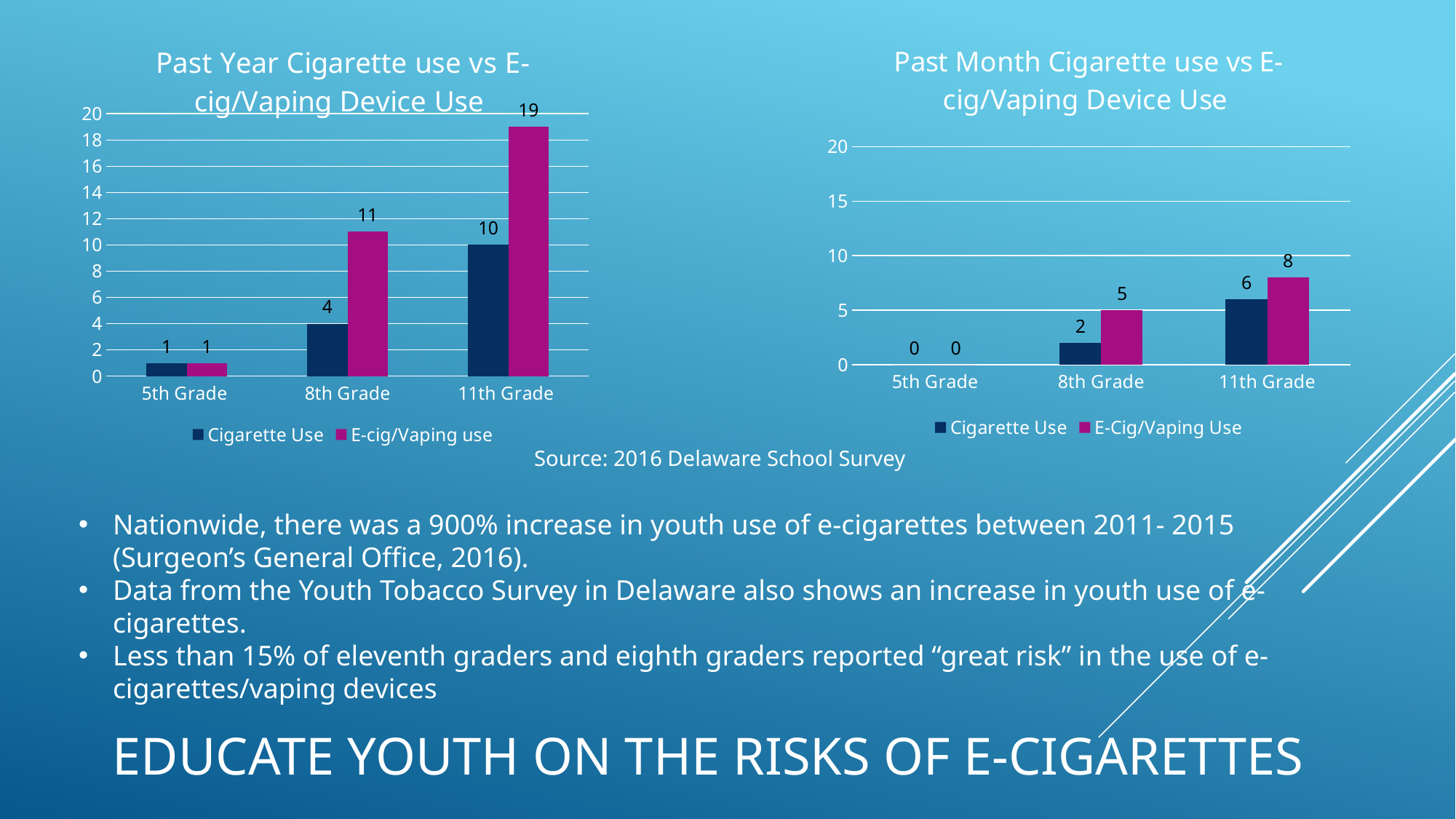
In the 'Past Year Cigarette use vs E-cig/Vaping Device Use' chart, which grade has the highest E-cig/Vaping use? 11th Grade In the 'Past Year Cigarette use vs E-cig/Vaping Device Use' chart, what is the E-cig/Vaping use value for 11th Grade? 19 In the 'Past Year Cigarette use vs E-cig/Vaping Device Use' chart, how many grade categories are shown? 3 What kind of chart is the 'Past Year Cigarette use vs E-cig/Vaping Device Use' chart? Bar chart In the 'Past Month Cigarette use vs E-cig/Vaping Device Use' chart, which is larger for 11th Grade: Cigarette Use or E-Cig/Vaping Use? E-Cig/Vaping Use In the 'Past Year Cigarette use vs E-cig/Vaping Device Use' chart, do E-cig/Vaping use values rise or fall from 5th Grade to 11th Grade? Rise In the 'Past Month Cigarette use vs E-cig/Vaping Device Use' chart, what is the Cigarette Use value for 11th Grade? 6 In the 'Past Month Cigarette use vs E-cig/Vaping Device Use' chart, which grade has the lowest Cigarette Use? 5th Grade In the 'Past Year Cigarette use vs E-cig/Vaping Device Use' chart, what is the difference between E-cig/Vaping use and Cigarette Use for 11th Grade? 9 In the 'Past Year Cigarette use vs E-cig/Vaping Device Use' chart, what is the Cigarette Use value for 8th Grade? 4 In the 'Past Month Cigarette use vs E-cig/Vaping Device Use' chart, what is the E-Cig/Vaping Use value for 8th Grade? 5 In the 'Past Month Cigarette use vs E-cig/Vaping Device Use' chart, how many series does the legend list? 2